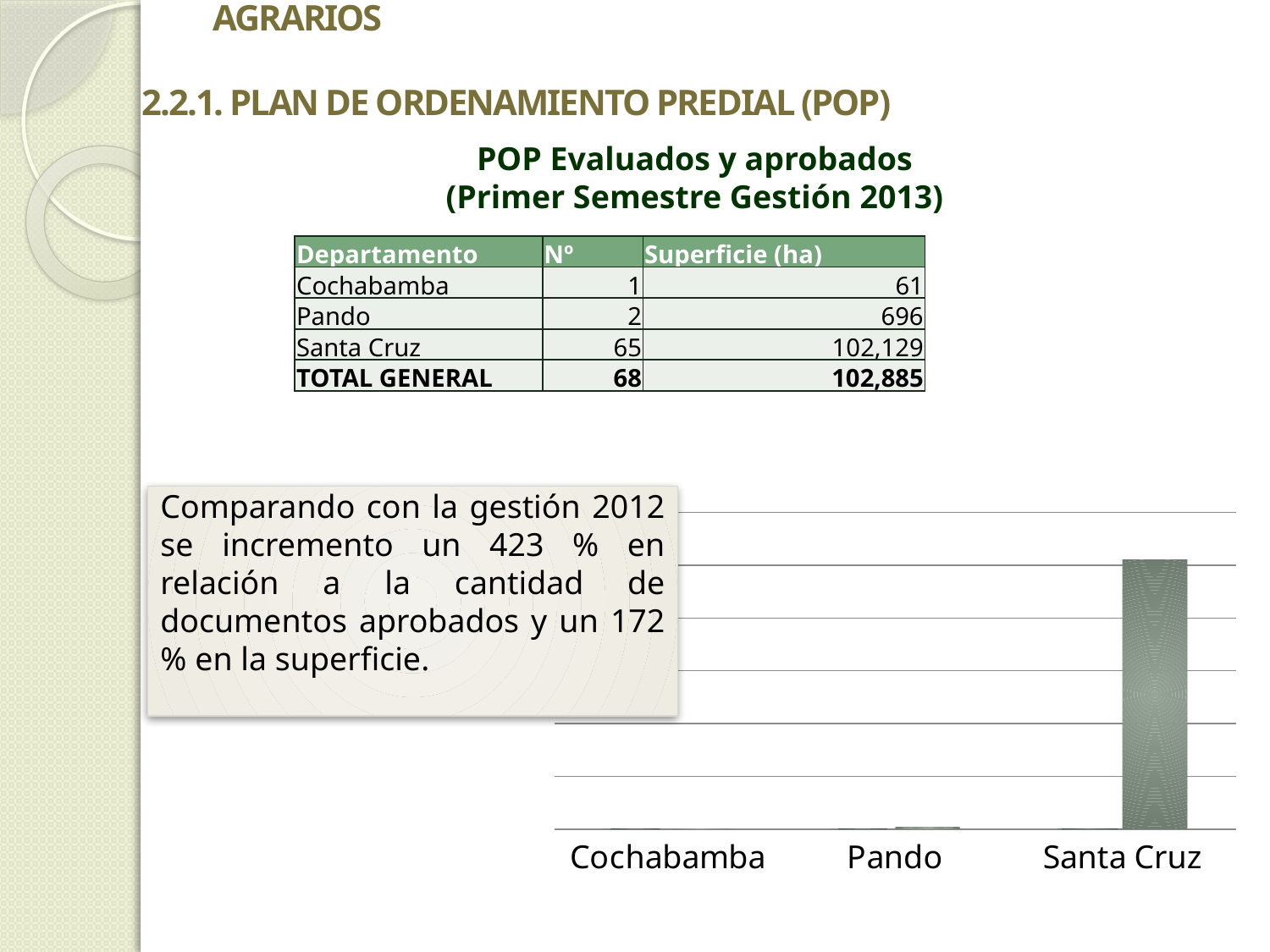
How many categories are shown on the x axis of the bar chart? 3 Does the bar chart display data labels on its bars? No In the bar chart, which is larger, the bar for Pando or the bar for Cochabamba? Pando In the bar chart, which is larger, the bar for Santa Cruz or the bar for Pando? Santa Cruz What kind of chart is shown at the bottom right of the slide? bar chart What are the category labels along the x axis of the bar chart, from left to right? Cochabamba, Pando, Santa Cruz Which category has the highest bar in the chart? Santa Cruz Which category has the lowest bar in the chart? Cochabamba